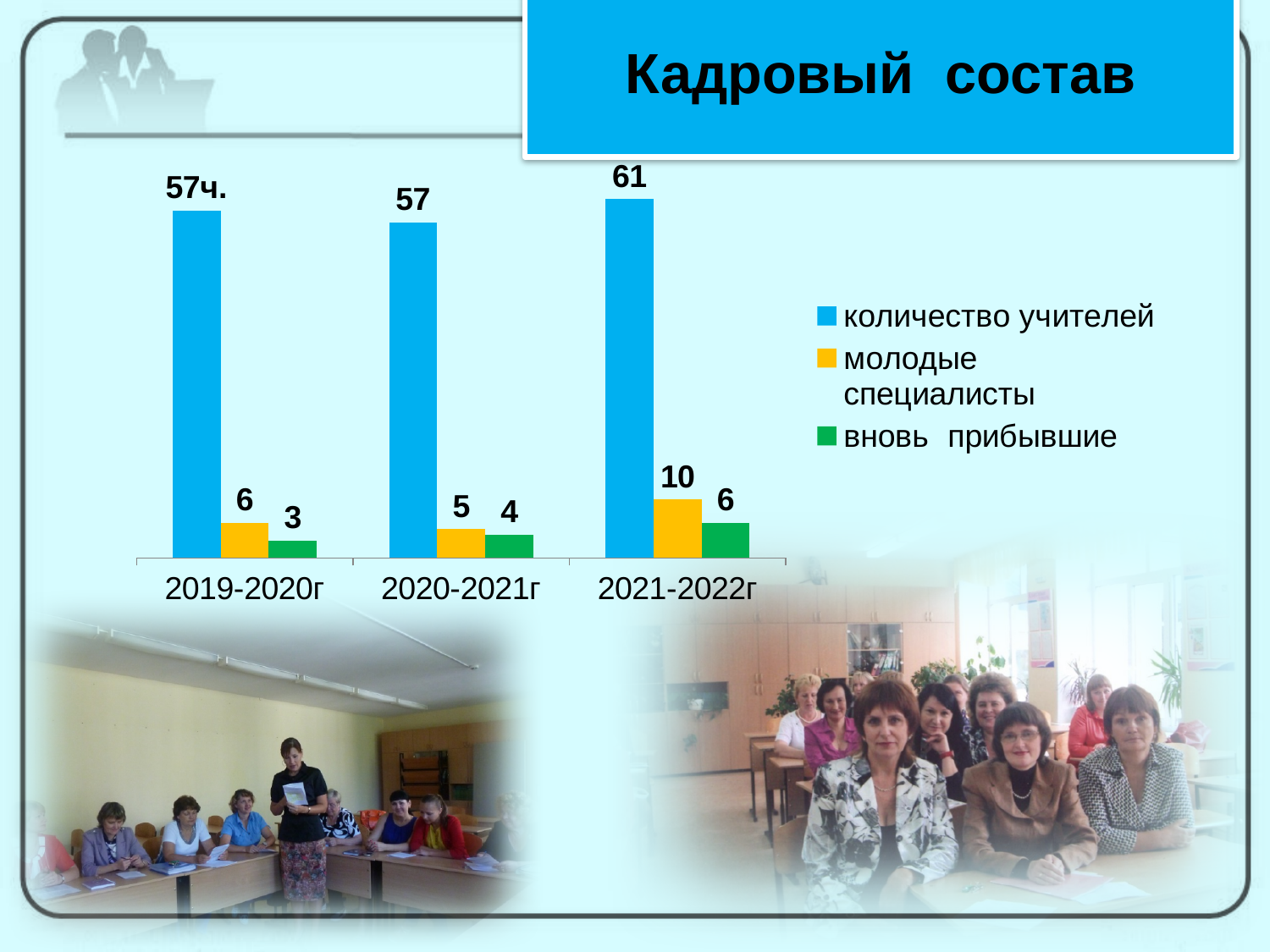
What is the value for вновь прибывшие in 2019-2020г? 3 How many year categories are shown on the x axis? 3 Does the value for вновь прибывшие rise or fall from 2019-2020г to 2021-2022г? rise In which year is the value for вновь прибывшие lowest? 2019-2020г What is the value for молодые специалисты in 2020-2021г? 5 In which year is the value for молодые специалисты highest? 2021-2022г How many series does the legend list? 3 What is the value for количество учителей in 2021-2022г? 61 What kind of chart is shown on the slide? bar chart What is the difference between молодые специалисты in 2021-2022г and in 2020-2021г? 5 What is the data label shown for количество учителей in 2019-2020г? 57ч. Which is larger in 2020-2021г: молодые специалисты or вновь прибывшие? молодые специалисты